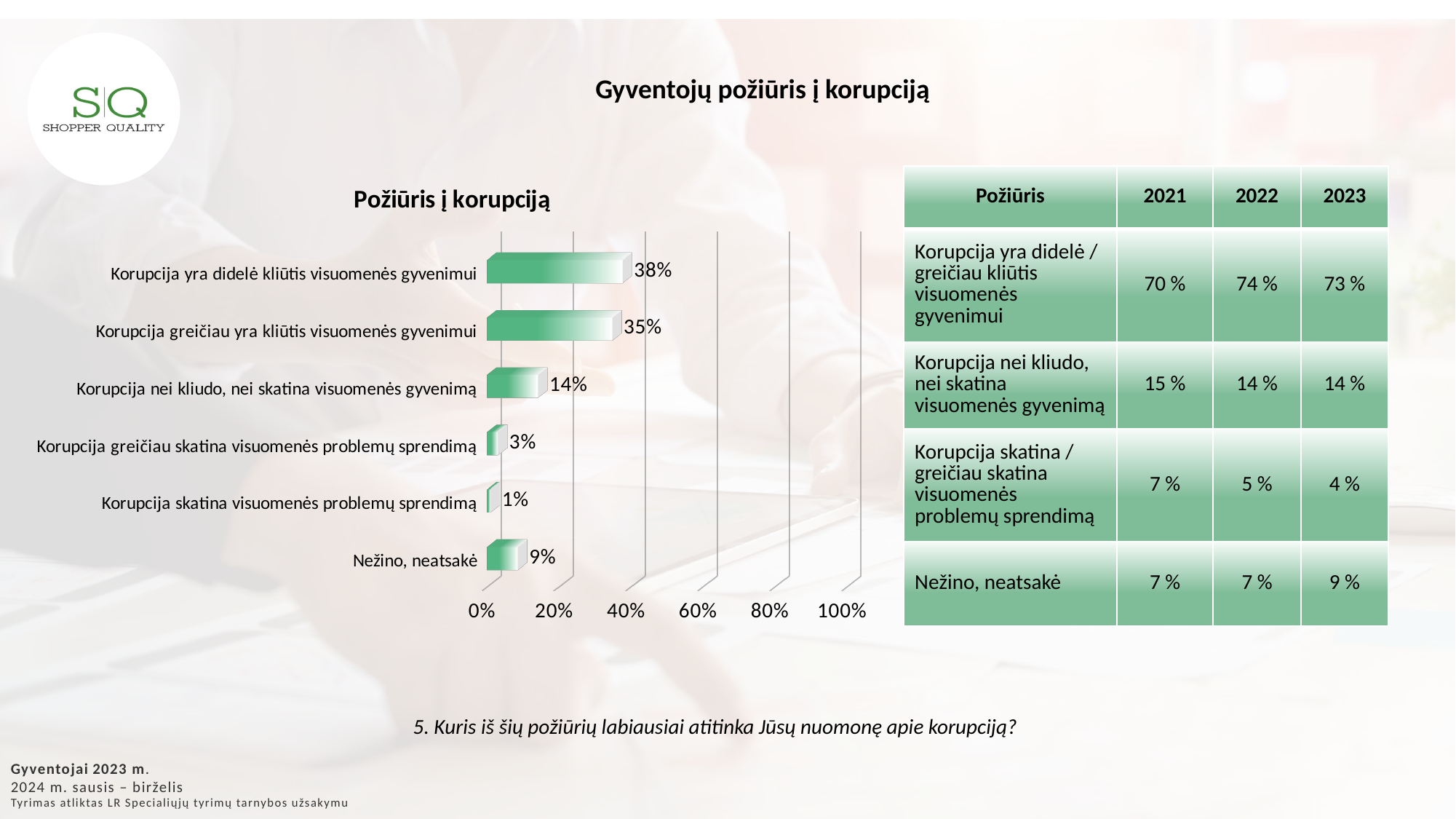
What is the title of the chart? Požiūris į korupciją What is the value for "Korupcija nei kliudo, nei skatina visuomenės gyvenimą" in the chart? 14% What is the value for "Korupcija yra didelė kliūtis visuomenės gyvenimui" in the chart? 38% Which category has the highest value in the chart? Korupcija yra didelė kliūtis visuomenės gyvenimui How many categories are shown in the chart? 6 Which category has the lowest value in the chart? Korupcija skatina visuomenės problemų sprendimą What kind of chart is shown on the slide? bar chart What is the difference between the values for "Korupcija yra didelė kliūtis visuomenės gyvenimui" and "Korupcija greičiau yra kliūtis visuomenės gyvenimui"? 3% Which is larger: the value for "Korupcija greičiau skatina visuomenės problemų sprendimą" or for "Nežino, neatsakė"? Nežino, neatsakė What is the value for "Nežino, neatsakė" in the chart? 9% What is the highest value shown on the chart's x axis? 100% Is the value for "Korupcija greičiau yra kliūtis visuomenės gyvenimui" greater or less than 20%? greater